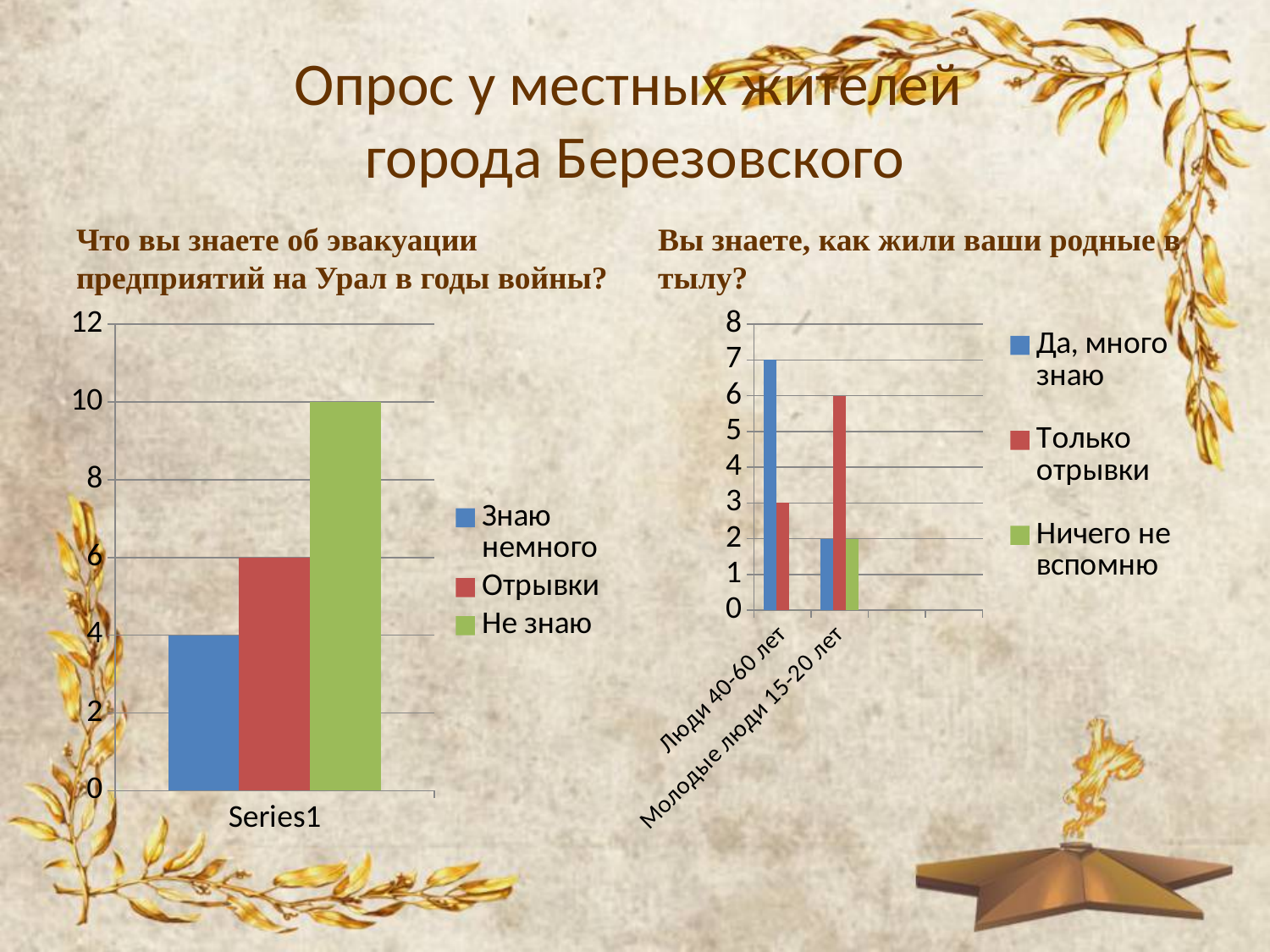
In the chart 'Что вы знаете об эвакуации предприятий на Урал в годы войны?', how many entries does the legend list? 3 In the chart 'Вы знаете, как жили ваши родные в тылу?', which is larger for 'Люди 40-60 лет': 'Да, много знаю' or 'Только отрывки'? Да, много знаю In the chart 'Что вы знаете об эвакуации предприятий на Урал в годы войны?', what is the difference between 'Не знаю' and 'Отрывки'? 4 In the chart 'Вы знаете, как жили ваши родные в тылу?', what is the difference between 'Да, много знаю' for 'Люди 40-60 лет' and 'Да, много знаю' for 'Молодые люди 15-20 лет'? 5 In the chart 'Вы знаете, как жили ваши родные в тылу?', what is the value of 'Да, много знаю' for 'Люди 40-60 лет'? 7 In the chart 'Что вы знаете об эвакуации предприятий на Урал в годы войны?', which legend entry has the highest value? Не знаю In the chart 'Что вы знаете об эвакуации предприятий на Урал в годы войны?', what is the value for 'Знаю немного'? 4 In the chart 'Что вы знаете об эвакуации предприятий на Урал в годы войны?', what is the value for 'Не знаю'? 10 In the chart 'Вы знаете, как жили ваши родные в тылу?', how many categories are shown on the x axis? 2 In the chart 'Вы знаете, как жили ваши родные в тылу?', what is the value of 'Только отрывки' for 'Молодые люди 15-20 лет'? 6 What kind of chart is the chart 'Вы знаете, как жили ваши родные в тылу?'? bar chart In the chart 'Что вы знаете об эвакуации предприятий на Урал в годы войны?', which legend entry has the lowest value? Знаю немного